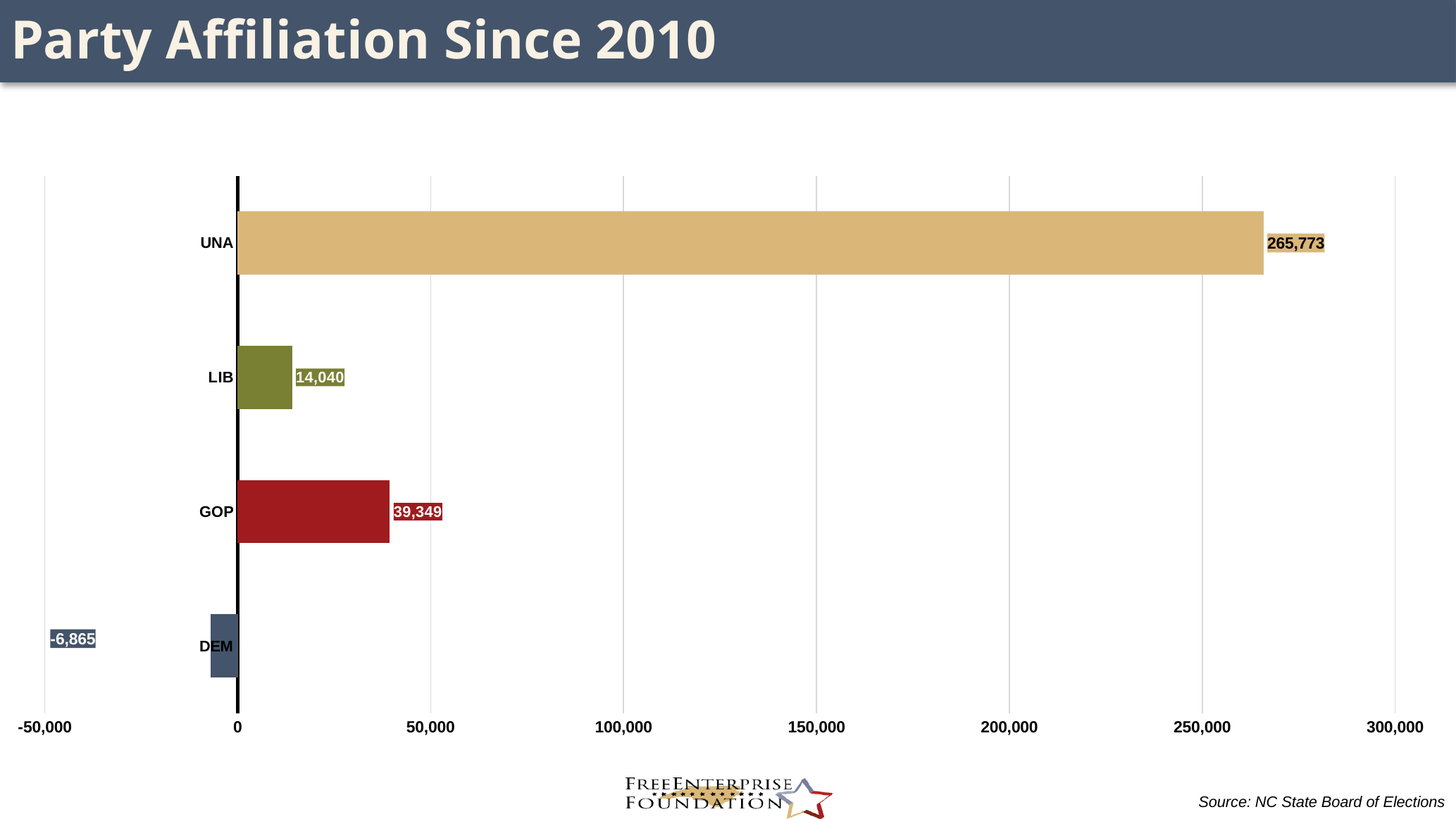
What is the difference between the values for GOP and LIB? 25,309 Which is larger, the value for GOP or the value for LIB? GOP What is the value for LIB? 14,040 What is the value for DEM? -6,865 How many categories are shown in the chart? 4 What is the value for UNA? 265,773 Is the value for UNA greater or less than 250,000? greater What kind of chart is shown on the slide? bar chart Which category has the lowest value? DEM What is the title of the slide? Party Affiliation Since 2010 Which category has the highest value? UNA What is the value for GOP? 39,349